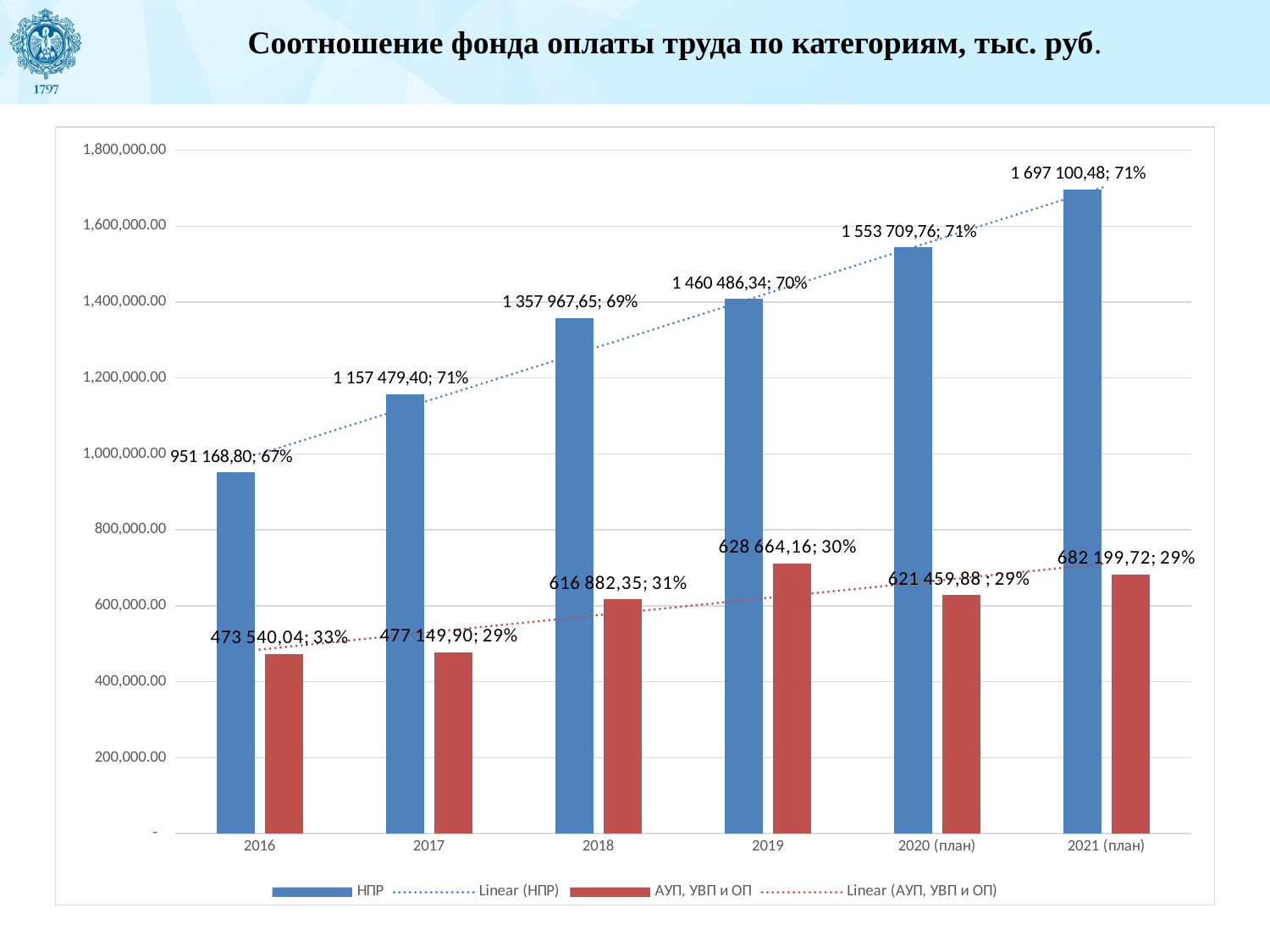
What is the difference between the НПР value for 2021 (план) and the НПР value for 2016? 745 931,68 Is the НПР value for 2018 greater or less than 1,200,000.00? greater Do the НПР values rise or fall from 2016 to 2021 (план)? rise Which is larger: the АУП, УВП и ОП value for 2019 or for 2020 (план)? 2019 What percentage share is shown in the data label for НПР in 2016? 67% How many entries does the legend list? 4 What is the value of the АУП, УВП и ОП bar for 2021 (план)? 682 199,72 What is the value of the НПР bar for 2018? 1 357 967,65 What is the value of the АУП, УВП и ОП bar for 2019? 628 664,16 How many year categories are shown on the x axis? 6 In which year is the НПР bar the highest? 2021 (план) In which year is the АУП, УВП и ОП bar the lowest? 2016